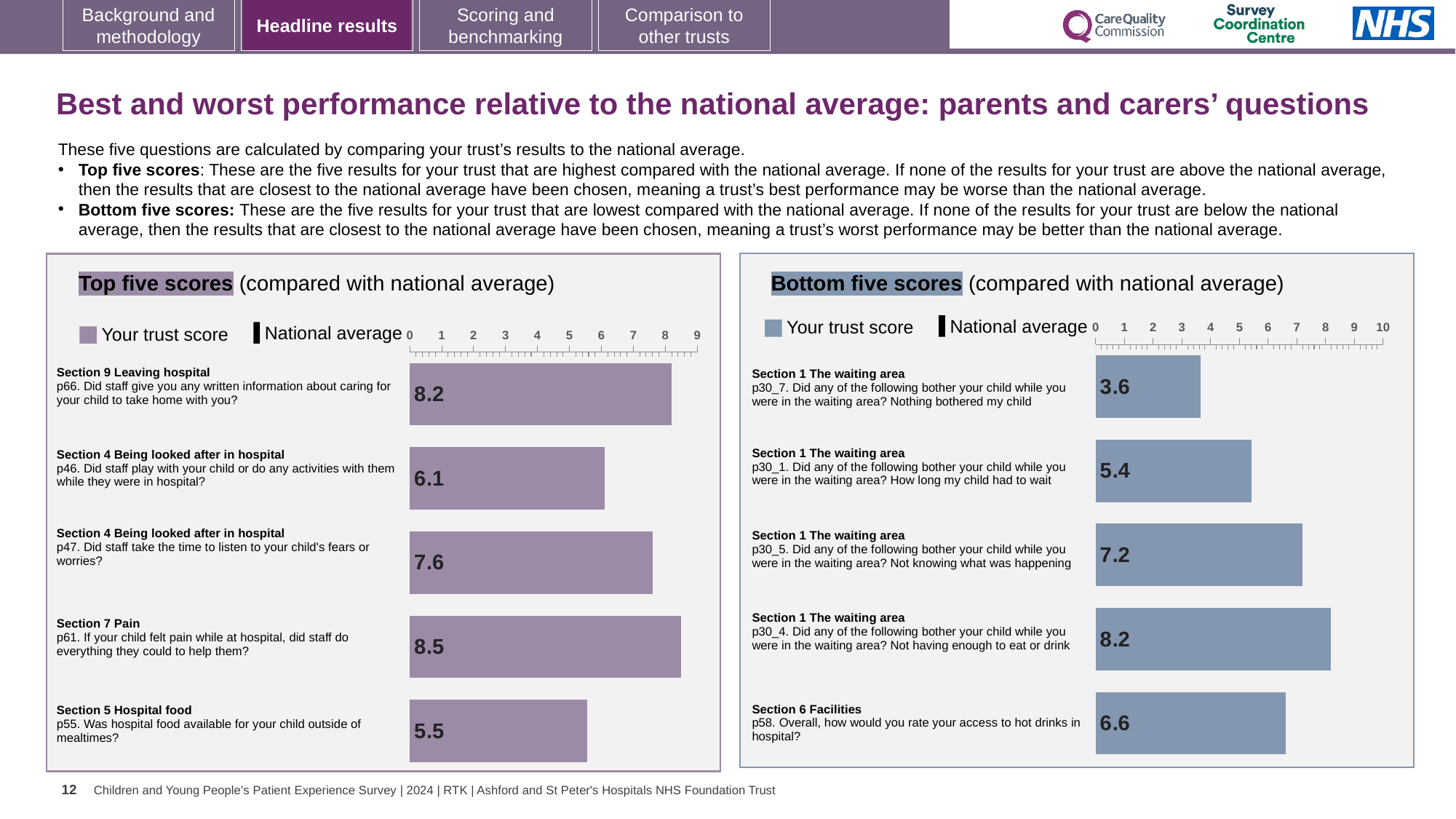
In the Top five scores chart, which has the larger trust score: p46 or p47? p47 In the Top five scores chart, what is the difference between the trust scores for p61 and p55? 3.0 How many questions are shown in the Bottom five scores chart? 5 In the Top five scores chart, which question has the lowest trust score? p55 (Section 5 Hospital food) In the Top five scores chart, what is the trust score for p66 (written information about caring for your child to take home)? 8.2 In the Bottom five scores chart, what is the trust score for p30_7 (Nothing bothered my child in the waiting area)? 3.6 In the Bottom five scores chart, what is the difference between the trust scores for p30_4 and p30_7? 4.6 In the Bottom five scores chart, which question has the highest trust score? p30_4 (Section 1 The waiting area) How many series does the legend of the Top five scores chart list? 2 In the Top five scores chart, which question has the highest trust score? p61 (Section 7 Pain) In the Bottom five scores chart, which question has the lowest trust score? p30_7 (Section 1 The waiting area) What kind of chart is the Bottom five scores chart? Bar chart